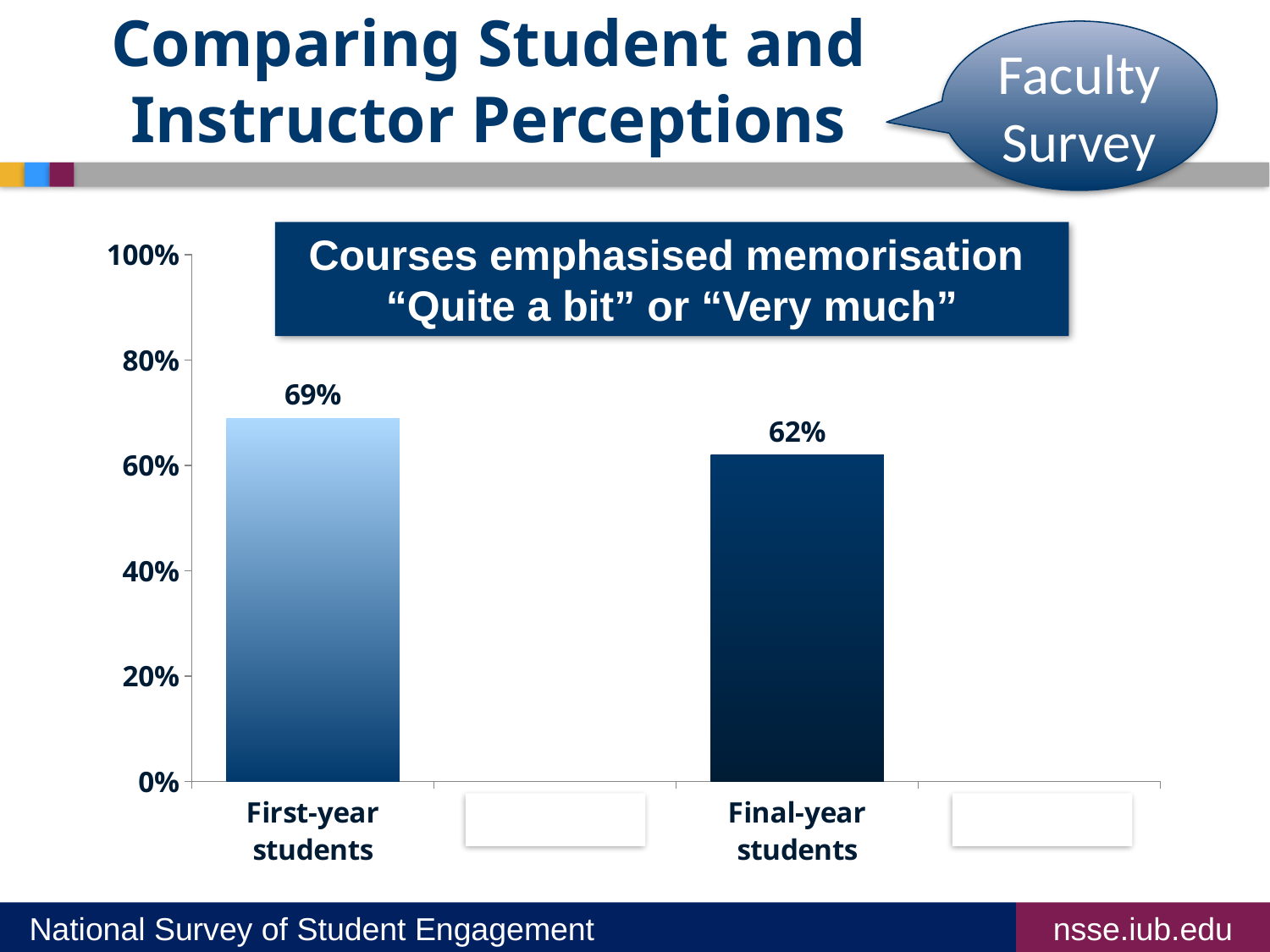
Which category has the highest value? First-year students How many bars are plotted on the chart? 2 What is the difference between the values for First-year students and Final-year students? 7% Is the value for First-year students greater or less than 80%? less Is the value for Final-year students greater or less than 60%? greater What is the value for First-year students? 69% What kind of chart is shown on the slide? Bar chart Which is larger, the value for First-year students or the value for Final-year students? First-year students What is the title of the chart? Courses emphasised memorisation "Quite a bit" or "Very much" Which category has the lowest value? Final-year students What is the highest value shown on the vertical axis? 100% What is the value for Final-year students? 62%